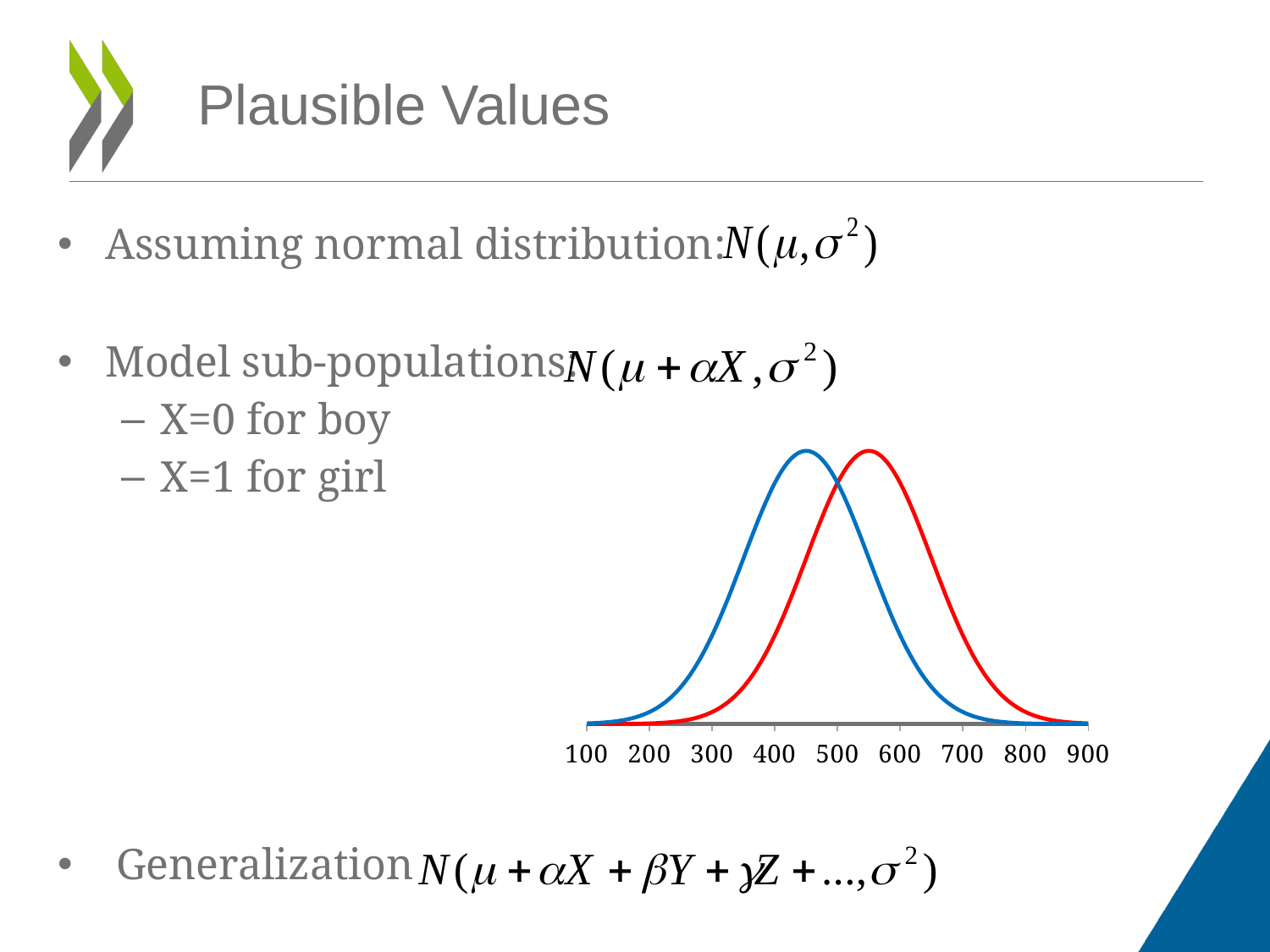
How many tick labels are shown on the x axis of the chart? 9 Is the peak of the blue curve located at an x value greater or less than 500? less How many curves are plotted on the chart? 2 What is the highest value labelled on the x axis of the chart? 900 Does the chart include a legend? No Which curve peaks further to the right on the x axis, the blue one or the red one? the red one Is the peak of the red curve located at an x value greater or less than 500? greater What kind of chart is shown on the slide? line chart What is the lowest value labelled on the x axis of the chart? 100 What colours are the two curves on the chart? blue and red